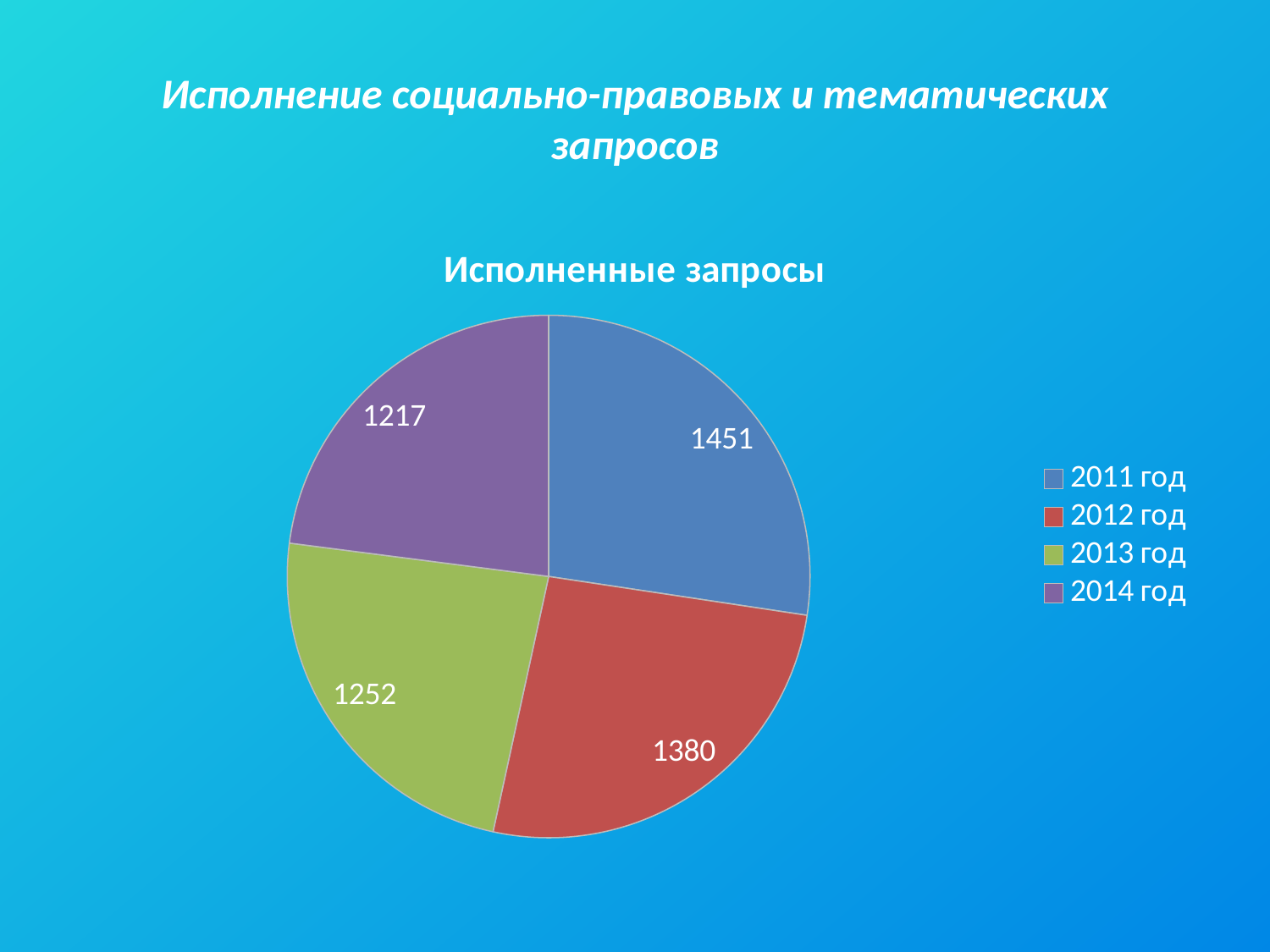
How many slices does the pie chart have? 4 Which year has the smallest slice? 2014 год What is the difference between the values for 2012 год and 2013 год? 128 What is the value for 2012 год? 1380 Which is larger, the value for 2012 год or the value for 2013 год? 2012 год What type of chart is shown on the slide? pie chart Which year has the largest slice? 2011 год What is the difference between the values for 2011 год and 2014 год? 234 What is the value for 2011 год? 1451 What is the value for 2013 год? 1252 What is the value for 2014 год? 1217 What is the title of the pie chart? Исполненные запросы